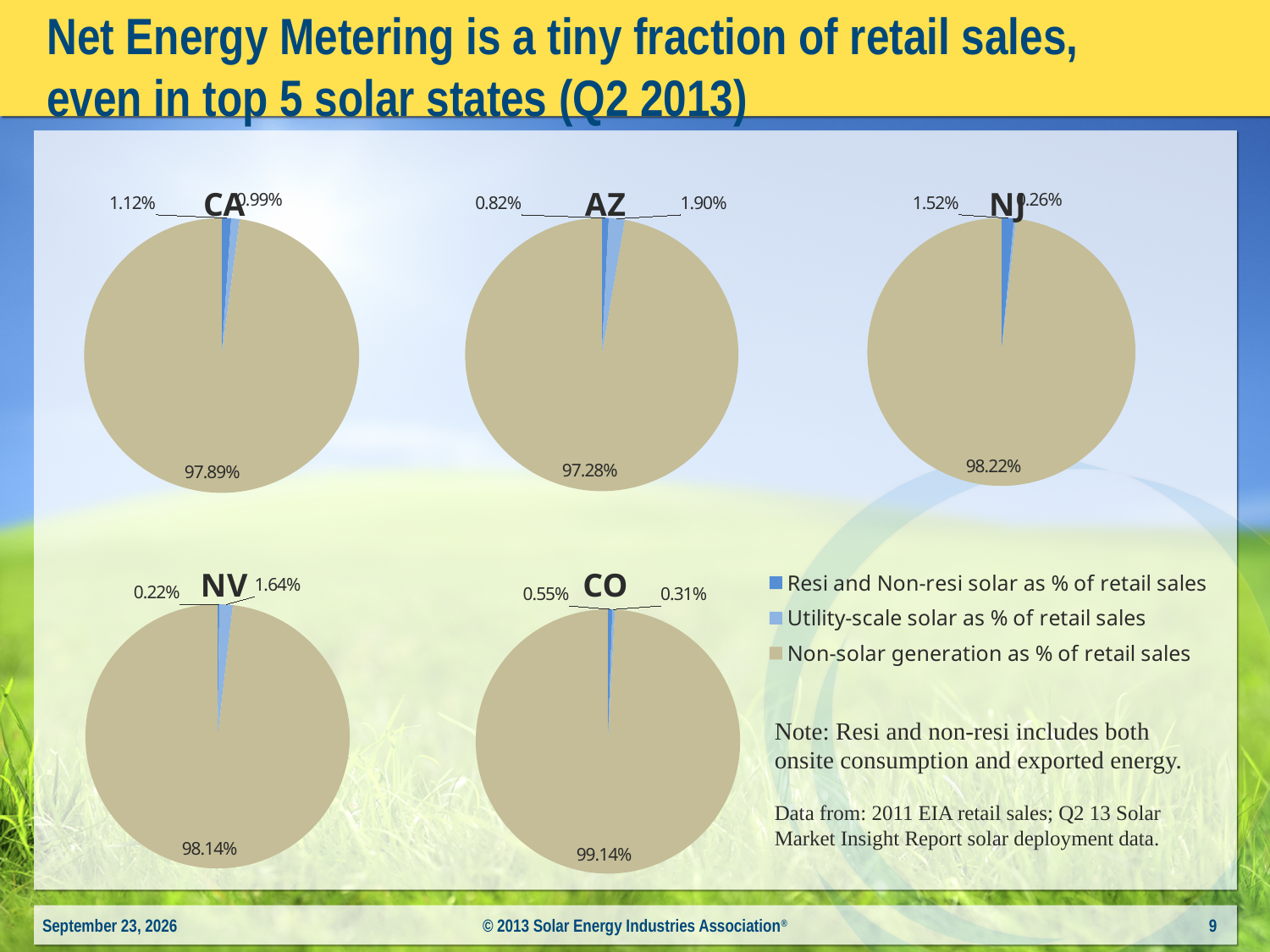
Is the non-solar generation share larger in the CO pie chart or the AZ pie chart? CO What is the difference between the non-solar generation shares in the CO and AZ pie charts? 1.86% Which state's pie chart has the smallest non-solar generation share? AZ How many pie charts are on the slide? 5 In the CA pie chart, what is the value of the non-solar generation slice? 97.89% What kind of charts are shown on the slide? Pie charts Which state's pie chart has the largest non-solar generation share? CO In the NV pie chart, what is the value of the non-solar generation slice? 98.14% In the CO pie chart, what is the value of the non-solar generation slice? 99.14% In the NJ pie chart, what is the value of the non-solar generation slice? 98.22% How many series does the legend list? 3 In the AZ pie chart, what is the value of the non-solar generation slice? 97.28%